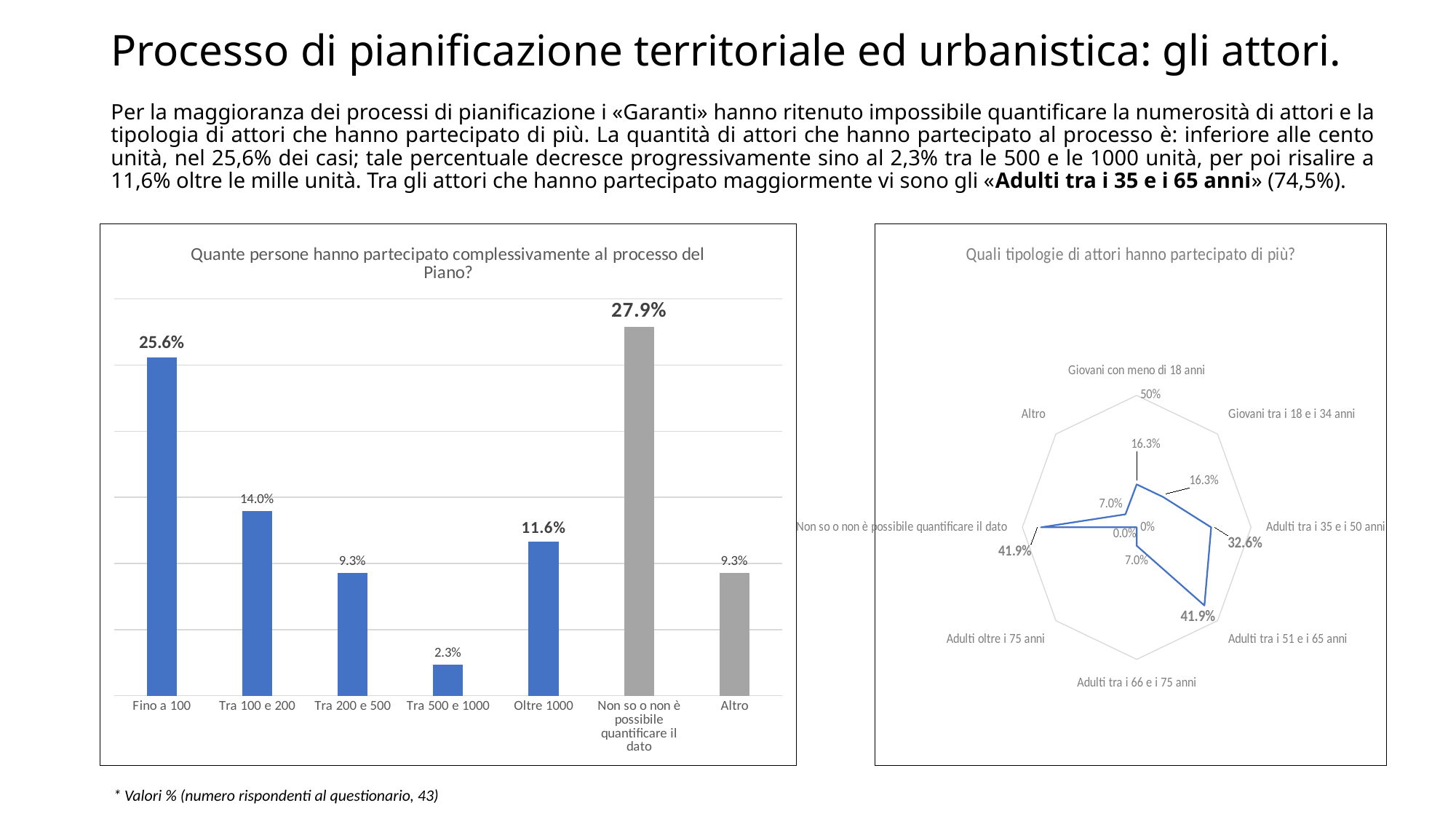
In the right chart 'Quali tipologie di attori hanno partecipato di più?', what is the value for 'Adulti tra i 51 e i 65 anni'? 41.9% What kind of chart is the right chart 'Quali tipologie di attori hanno partecipato di più?'? radar chart In the left chart 'Quante persone hanno partecipato complessivamente al processo del Piano?', which category has the highest value? Non so o non è possibile quantificare il dato In the right chart 'Quali tipologie di attori hanno partecipato di più?', which category has the lowest value? Adulti oltre i 75 anni In the left chart 'Quante persone hanno partecipato complessivamente al processo del Piano?', what is the difference between 'Fino a 100' and 'Tra 100 e 200'? 11.6% In the left chart 'Quante persone hanno partecipato complessivamente al processo del Piano?', what is the value for 'Tra 500 e 1000'? 2.3% In the left chart 'Quante persone hanno partecipato complessivamente al processo del Piano?', which is larger: 'Oltre 1000' or 'Tra 200 e 500'? Oltre 1000 In the right chart 'Quali tipologie di attori hanno partecipato di più?', what is the value for 'Adulti tra i 35 e i 50 anni'? 32.6% In the left chart 'Quante persone hanno partecipato complessivamente al processo del Piano?', which category has the lowest value? Tra 500 e 1000 In the left chart 'Quante persone hanno partecipato complessivamente al processo del Piano?', what is the value for 'Fino a 100'? 25.6% In the left chart 'Quante persone hanno partecipato complessivamente al processo del Piano?', how many categories are shown on the x axis? 7 What kind of chart is the left chart 'Quante persone hanno partecipato complessivamente al processo del Piano?'? bar chart